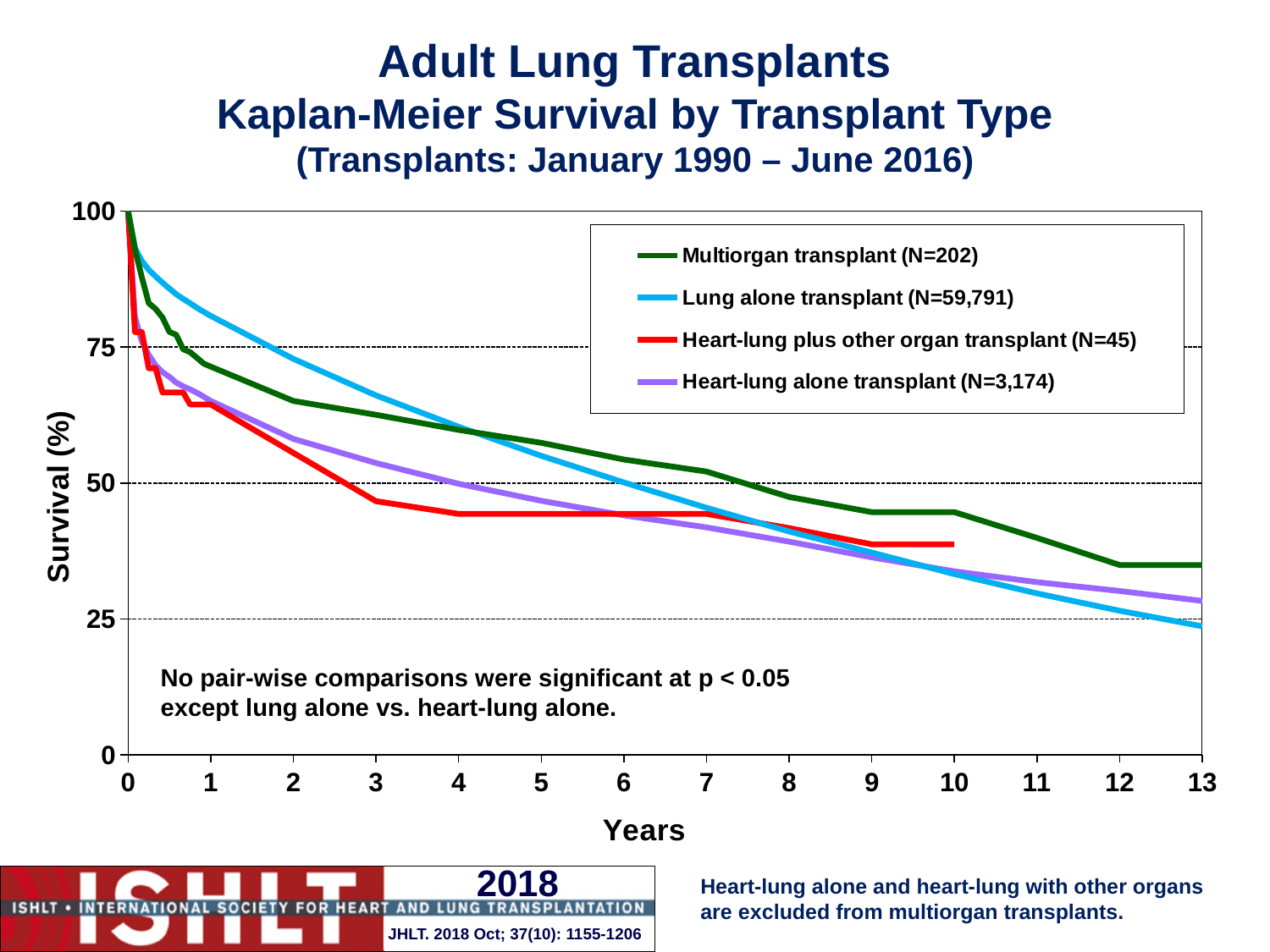
Which transplant type has the highest survival at year 13? Multiorgan transplant Is the survival value for Multiorgan transplant at year 5 greater or less than 50? greater Is the survival value for Heart-lung alone transplant at year 1 greater or less than 75? less How many series does the legend list? 4 What is the N shown in the legend for Lung alone transplant? 59,791 Which transplant type has the lowest survival at year 3? Heart-lung plus other organ transplant Is the survival value for Multiorgan transplant at year 13 greater or less than 50? less Do the survival curves rise or fall as years increase? fall At year 2, which has higher survival: Lung alone transplant or Heart-lung alone transplant? Lung alone transplant What kind of chart is shown on the slide? line chart